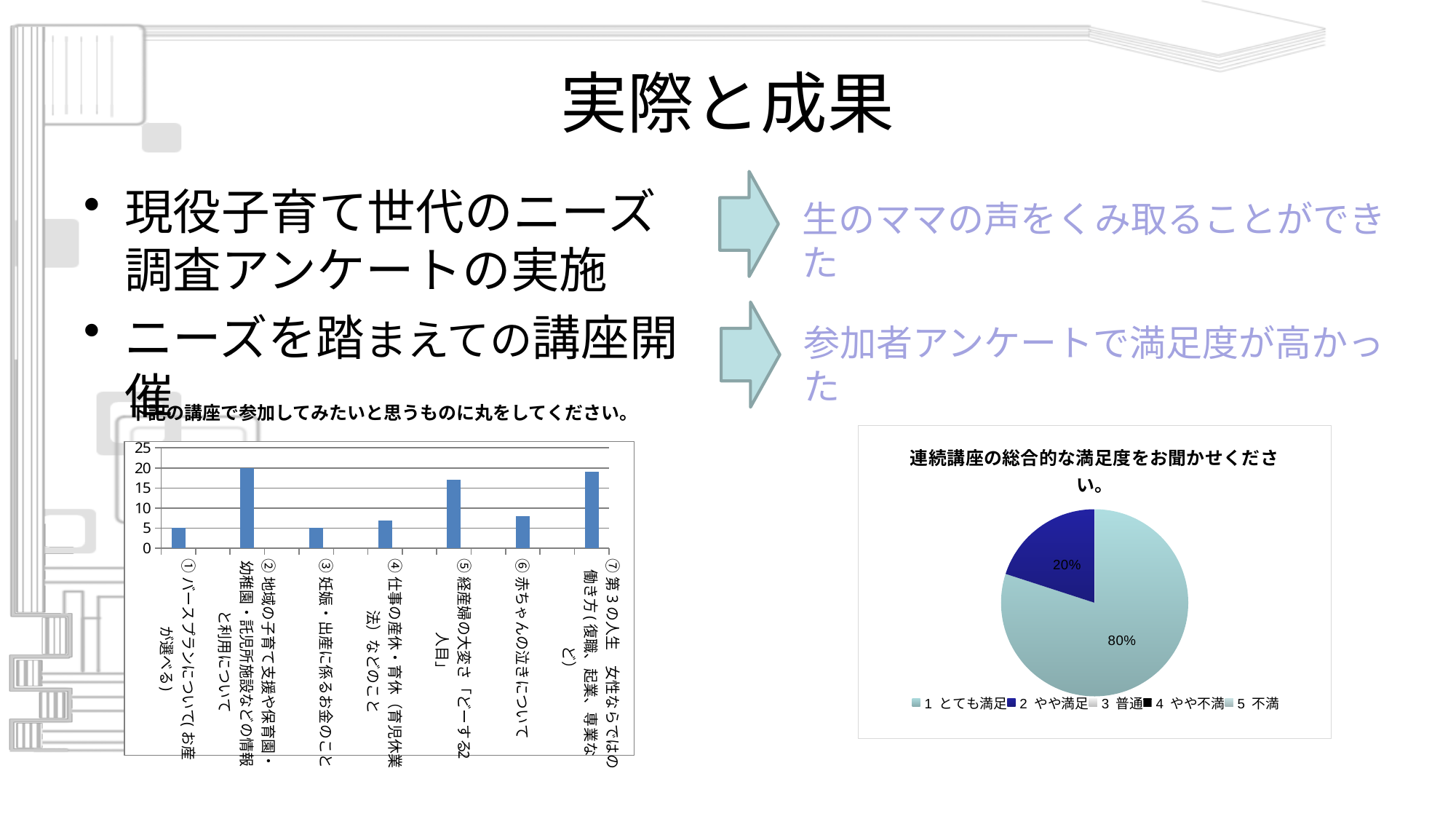
In the pie chart on the right, what is the difference between the shares for 「1 とても満足」 and 「2 やや満足」? 60% In the pie chart on the right, how many entries does the legend list? 5 In the pie chart on the right, what share is labelled for 「1 とても満足」? 80% What kind of chart is the chart on the right of the slide? pie chart In the bar chart on the left, which is larger, the value for category ② (地域の子育て支援や保育園・幼稚園・託児所施設などの情報と利用について) or category ④ (仕事の産休・育休（育児休業法）などのこと)? ② What kind of chart is the chart on the left of the slide? bar chart In the bar chart on the left, how many categories are plotted? 7 What is the title of the pie chart on the right? 連続講座の総合的な満足度をお聞かせください。 In the pie chart on the right, which slice is larger, 「1 とても満足」 or 「2 やや満足」? 1 とても満足 In the bar chart on the left, is the value for category ⑥ (赤ちゃんの泣きについて) greater or less than 10? less In the pie chart on the right, what share is labelled for 「2 やや満足」? 20% In the bar chart on the left, is the value for category ⑤ (経産婦の大変さ「どーする2人目」) greater or less than 15? greater